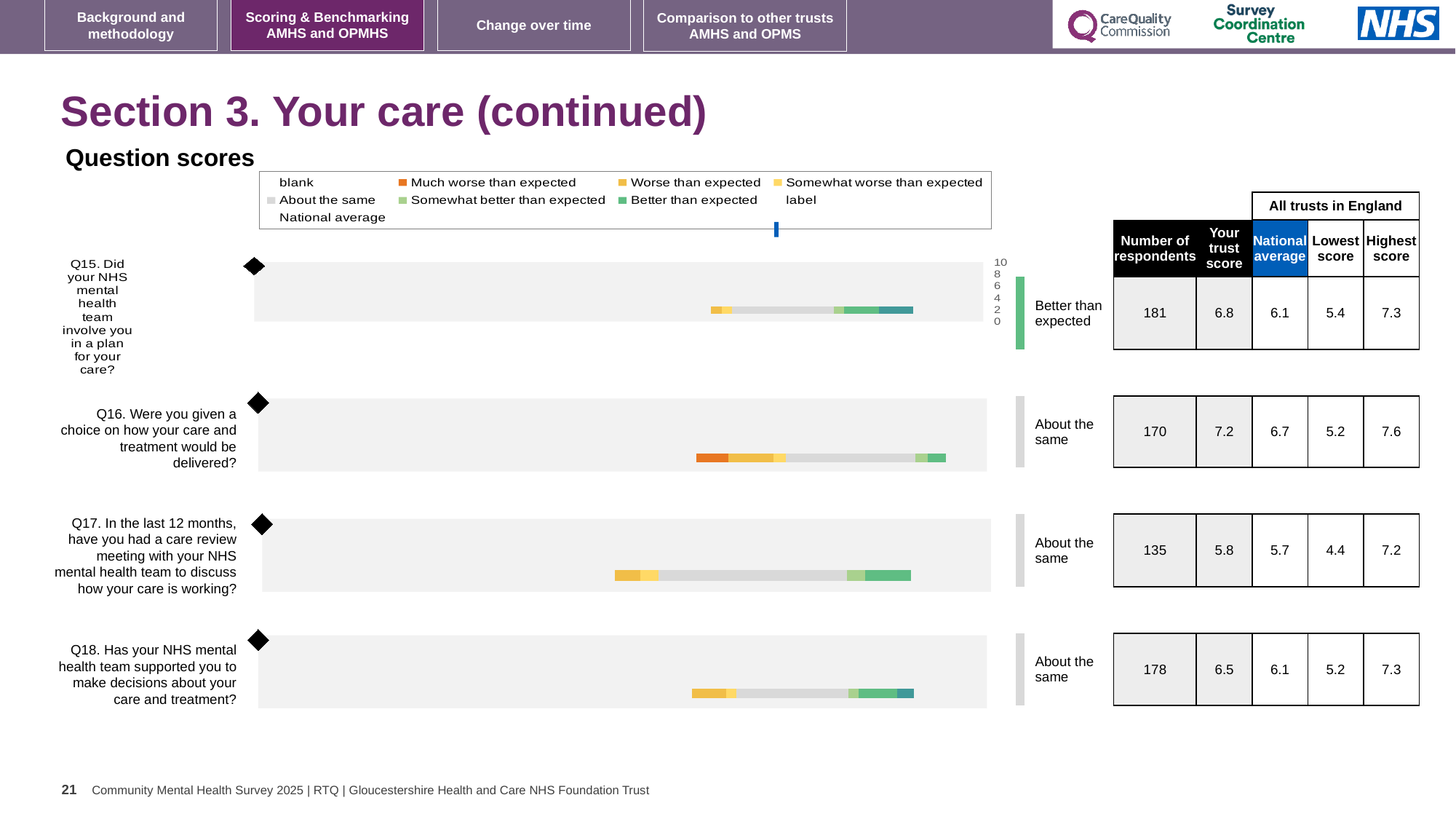
For Q15, how much higher is the trust score than the national average? 0.7 What is the 'Your trust score' value for Q16 (Were you given a choice on how your care and treatment would be delivered?)? 7.2 Which question has the highest 'Your trust score'? Q16 What is the national average score for Q17 (care review meeting in the last 12 months)? 5.7 What is the highest score among all trusts in England for Q18 (supported you to make decisions about your care and treatment)? 7.3 Which has the larger trust score, Q16 or Q18? Q16 Which question has the lowest number of respondents? Q17 For Q17, what is the difference between the highest score and the lowest score among all trusts in England? 2.8 How many respondents are listed for Q15 (Did your NHS mental health team involve you in a plan for your care?)? 181 How many questions are shown on the chart? 4 What kind of chart is used to show the question scores? Bar chart What comparison category is shown for Q15? Better than expected